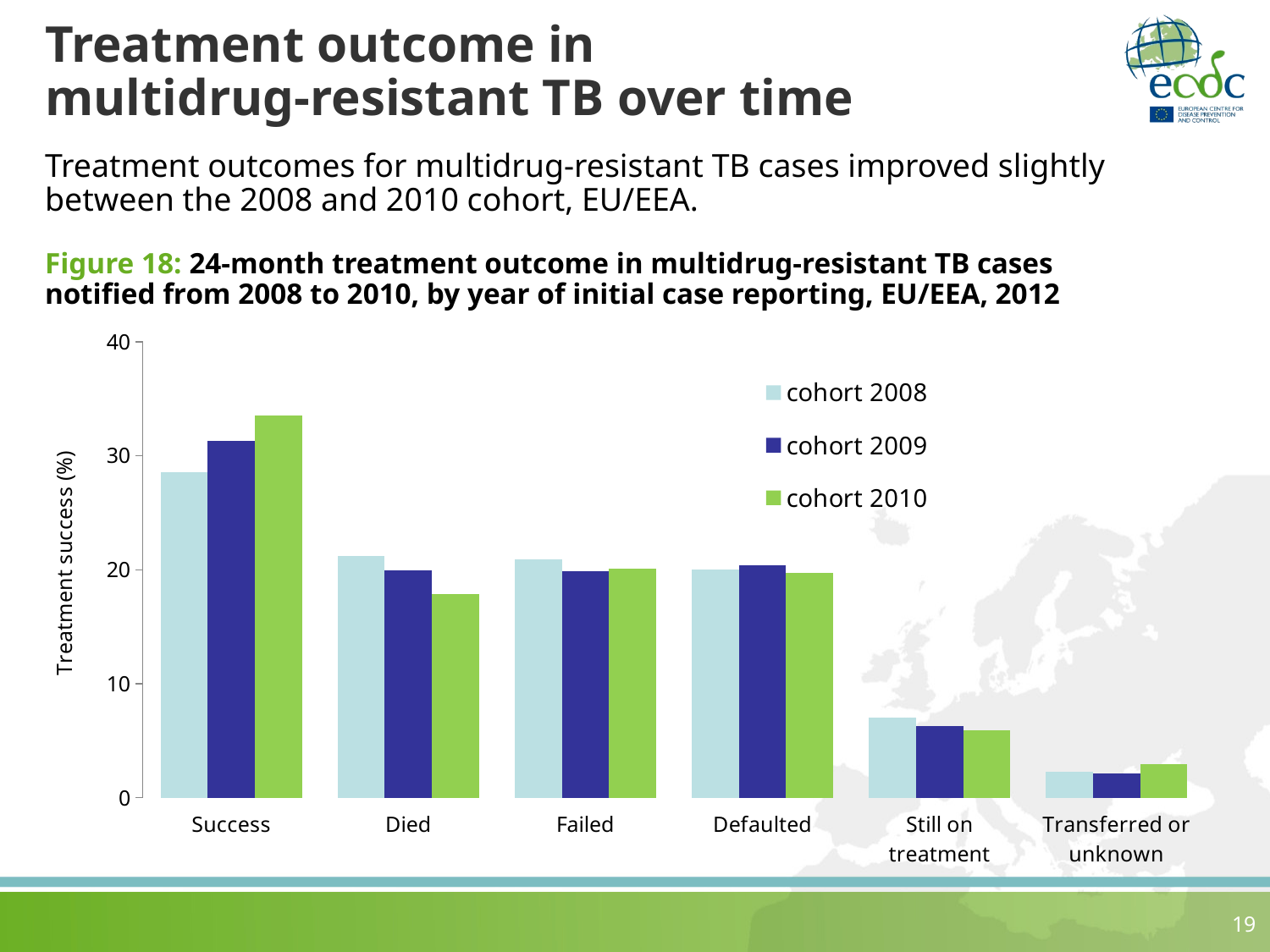
For the Died category, which is larger: cohort 2008 or cohort 2010? cohort 2008 Does the Success value rise or fall from cohort 2008 to cohort 2010? rise Which outcome category has the highest value for cohort 2010? Success Is the value for Success in cohort 2008 greater or less than 30? less Is the value for Still on treatment in cohort 2008 greater or less than 10? less Is the value for Success in cohort 2010 greater or less than 30? greater For the Success category, which is larger: cohort 2008 or cohort 2009? cohort 2009 What kind of chart is shown on the slide? Bar chart What is the label on the y axis of the chart? Treatment success (%) Which outcome category has the lowest value for cohort 2008? Transferred or unknown How many outcome categories are shown on the x axis? 6 How many series does the legend list? 3